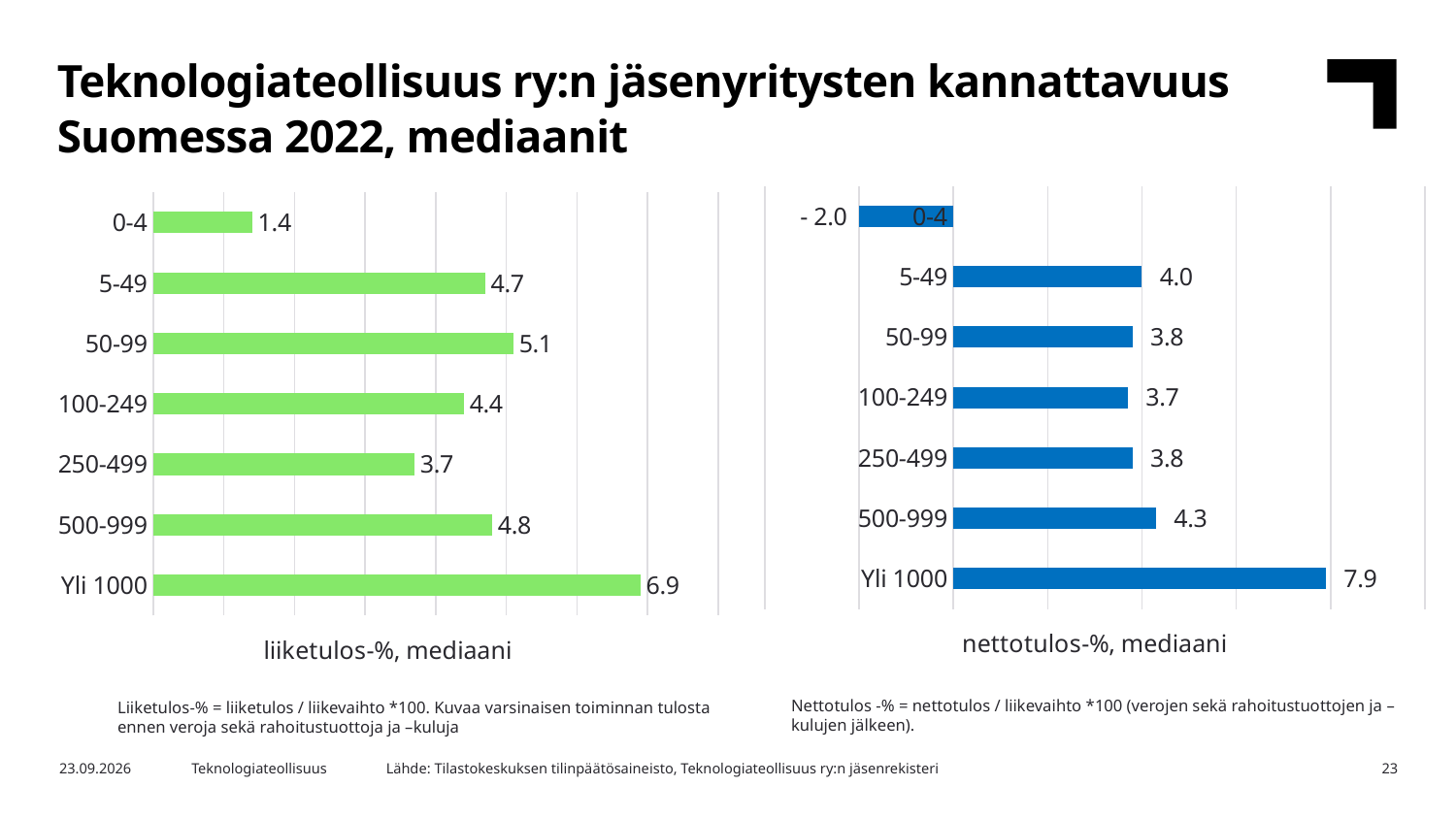
In the liiketulos-%, mediaani chart, which category has the lowest value? 0-4 What colour are the bars in the nettotulos-%, mediaani chart? Blue In the nettotulos-%, mediaani chart, what is the difference between the values for Yli 1000 and 5-49? 3.9 In the liiketulos-%, mediaani chart, what is the value for 50-99? 5.1 What kind of chart is the liiketulos-%, mediaani chart? Bar chart In the nettotulos-%, mediaani chart, what is the value for 500-999? 4.3 In the nettotulos-%, mediaani chart, which category has the highest value? Yli 1000 How many categories are shown in the nettotulos-%, mediaani chart? 7 In the liiketulos-%, mediaani chart, which is larger, the value for 5-49 or the value for 250-499? 5-49 In the liiketulos-%, mediaani chart, what is the value for Yli 1000? 6.9 In the nettotulos-%, mediaani chart, what is the value for 0-4? -2.0 In the liiketulos-%, mediaani chart, what is the difference between the values for Yli 1000 and 0-4? 5.5